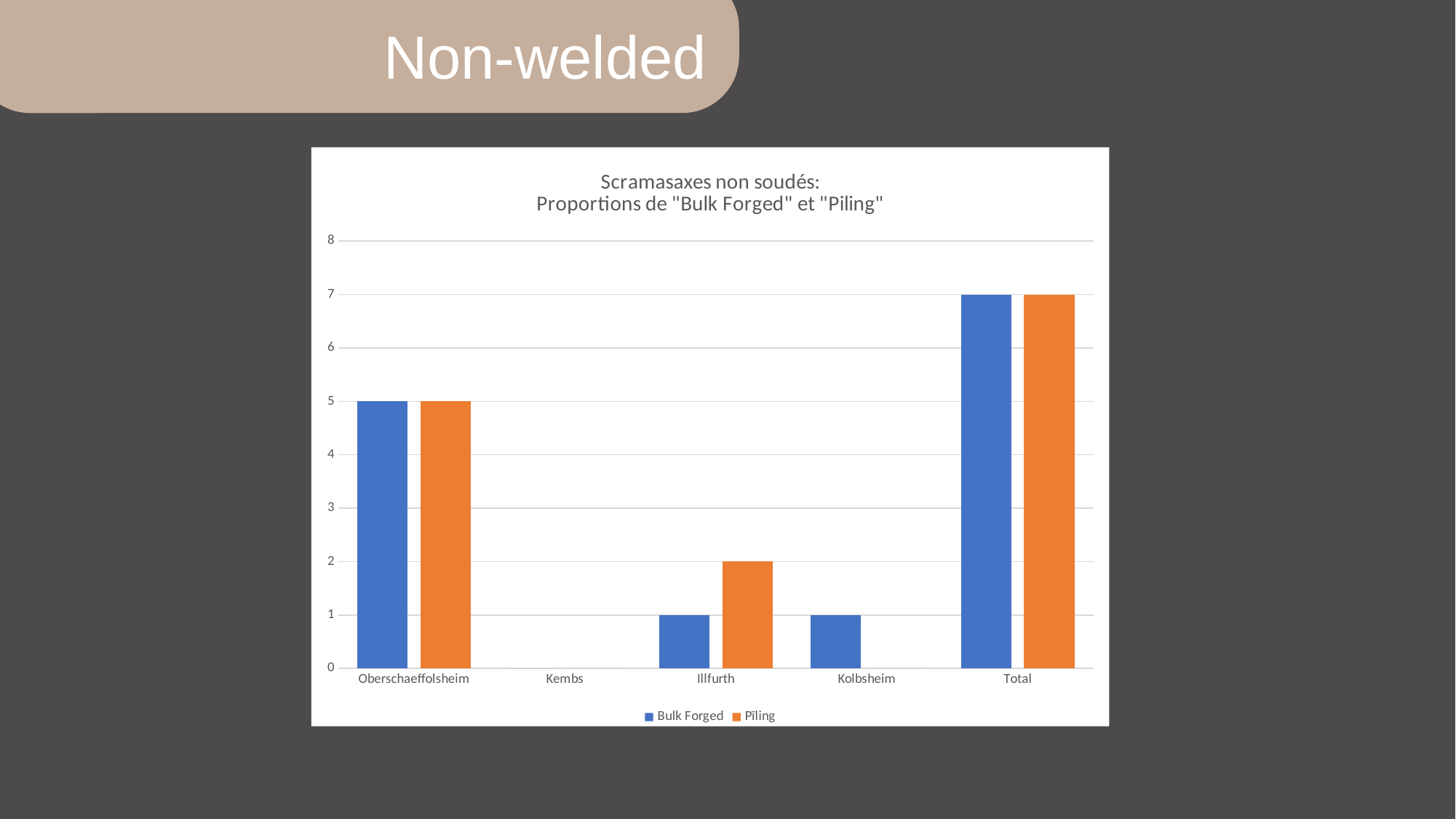
What is the difference between the Piling and Bulk Forged values for Illfurth? 1 Which category has the lowest Bulk Forged value? Kembs Which is larger for Illfurth, Bulk Forged or Piling? Piling Which category has the highest Piling value? Total What is the Bulk Forged value for Oberschaeffolsheim? 5 What is the Piling value for Illfurth? 2 What kind of chart is shown on the slide? Bar chart How many series does the legend list? 2 Which colour represents the Piling series? Orange What is the Bulk Forged value for Kolbsheim? 1 What is the Bulk Forged value for Total? 7 How many categories are shown on the x axis? 5